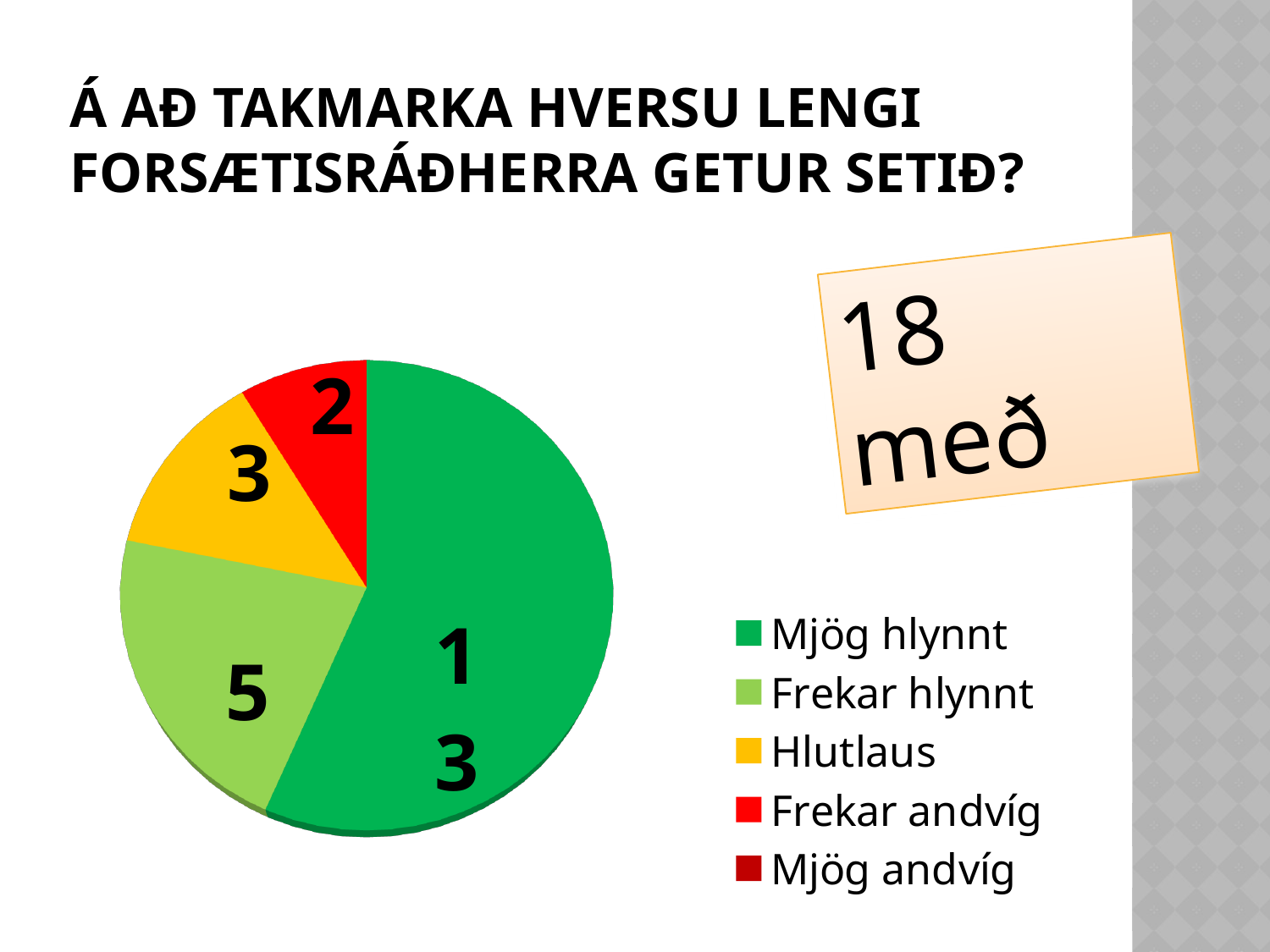
Which category has the largest slice of the pie? Mjög hlynnt What is the value for Hlutlaus? 3 How many entries does the legend list? 5 What is the value for Frekar andvíg? 2 What is the sum of the values shown on the pie slices? 23 Which is larger, the value for Hlutlaus or the value for Frekar andvíg? Hlutlaus Which of the visible slices is the smallest? Frekar andvíg What is the value for Frekar hlynnt? 5 What colour is the Hlutlaus slice? yellow What is the value for Mjög hlynnt? 13 What is the difference between the values for Mjög hlynnt and Frekar hlynnt? 8 What kind of chart is shown on the slide? pie chart